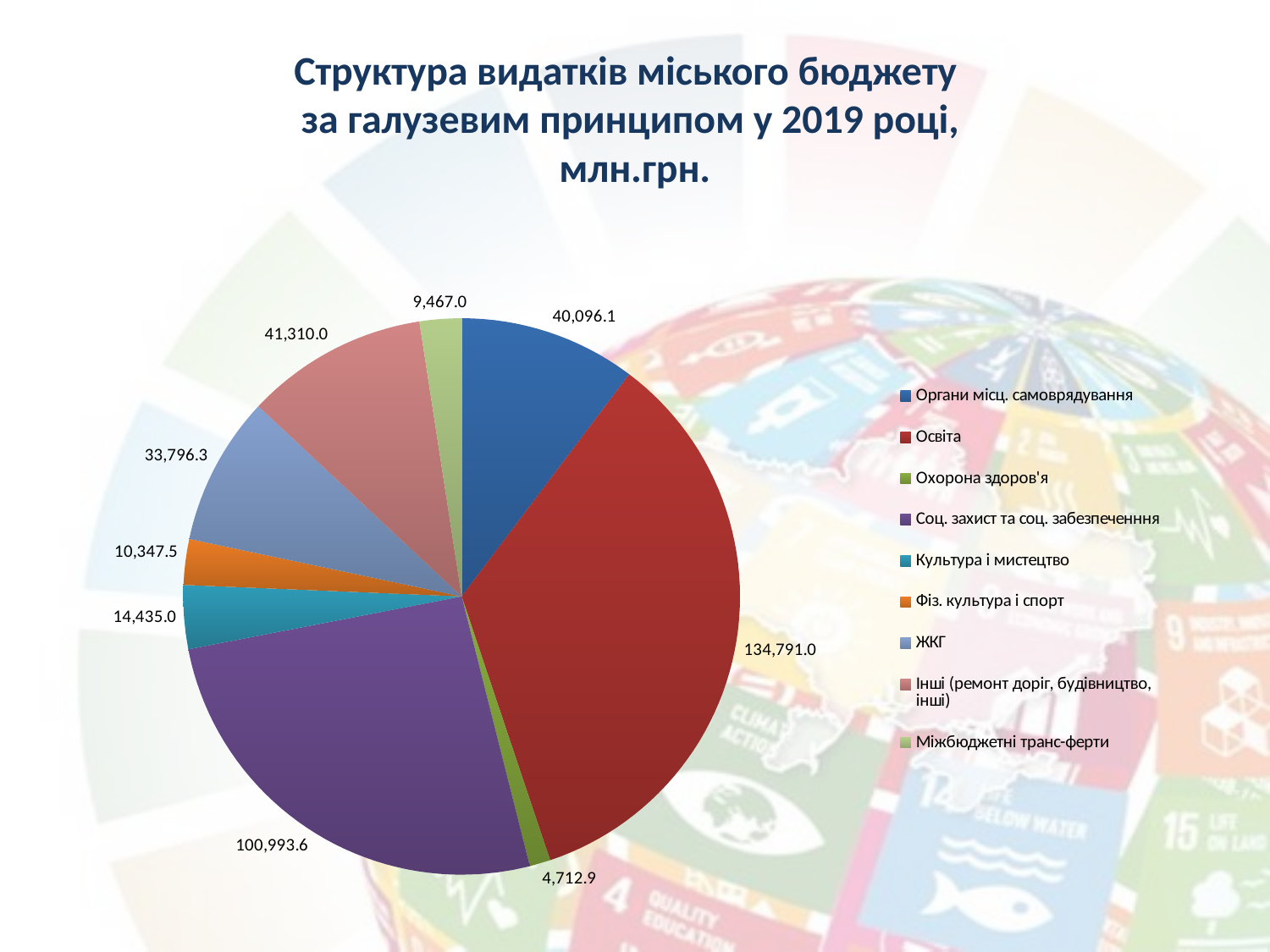
What is the difference between the values for ЖКГ and Культура і мистецтво? 19,361.3 What type of chart is shown on the slide? pie chart Which category has the largest slice of the pie? Освіта What is the value for Освіта? 134,791.0 Which is larger, the value for Культура і мистецтво or the value for Фіз. культура і спорт? Культура і мистецтво How many categories does the legend list? 9 Which category has the smallest slice of the pie? Охорона здоров'я What is the value for Соц. захист та соц. забезпеченння? 100,993.6 What is the difference between the values for Освіта and Соц. захист та соц. забезпеченння? 33,797.4 What is the value for Міжбюджетні транс-ферти? 9,467.0 What is the title of the chart? Структура видатків міського бюджету за галузевим принципом у 2019 році, млн.грн. What is the value for ЖКГ? 33,796.3